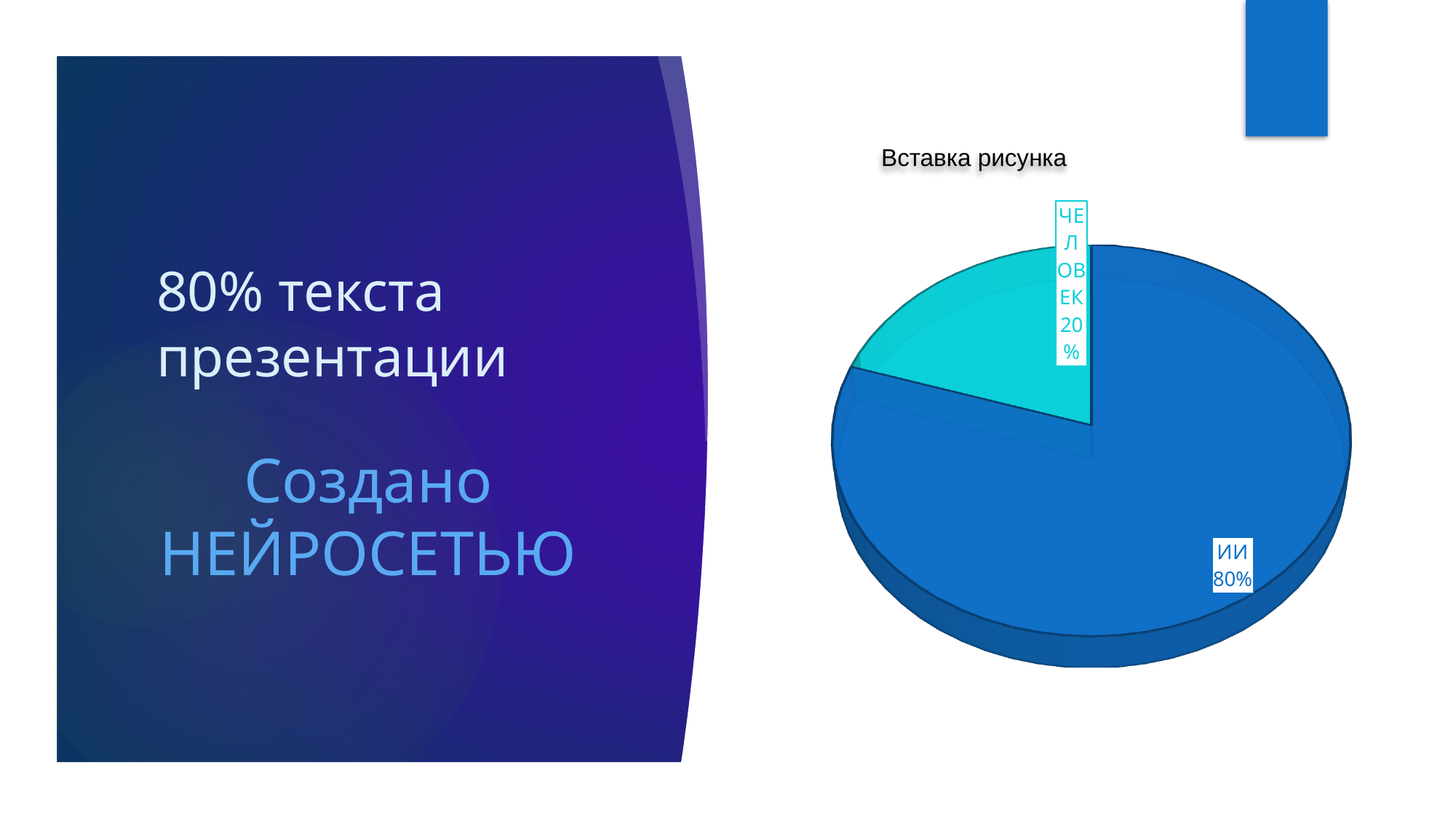
How many slices does the pie chart have? 2 What is the title shown above the pie chart? Вставка рисунка Which slice of the pie is the smallest? ЧЕЛОВЕК What share of the pie does the ЧЕЛОВЕК slice represent? 20% Which slice of the pie is the largest? ИИ What colour is the ЧЕЛОВЕК slice of the pie? cyan What share of the pie does the ИИ slice represent? 80% What kind of chart is shown on the slide? pie chart Which is larger, the ИИ slice or the ЧЕЛОВЕК slice? ИИ What is the difference in percentage points between the ИИ slice and the ЧЕЛОВЕК slice? 60%